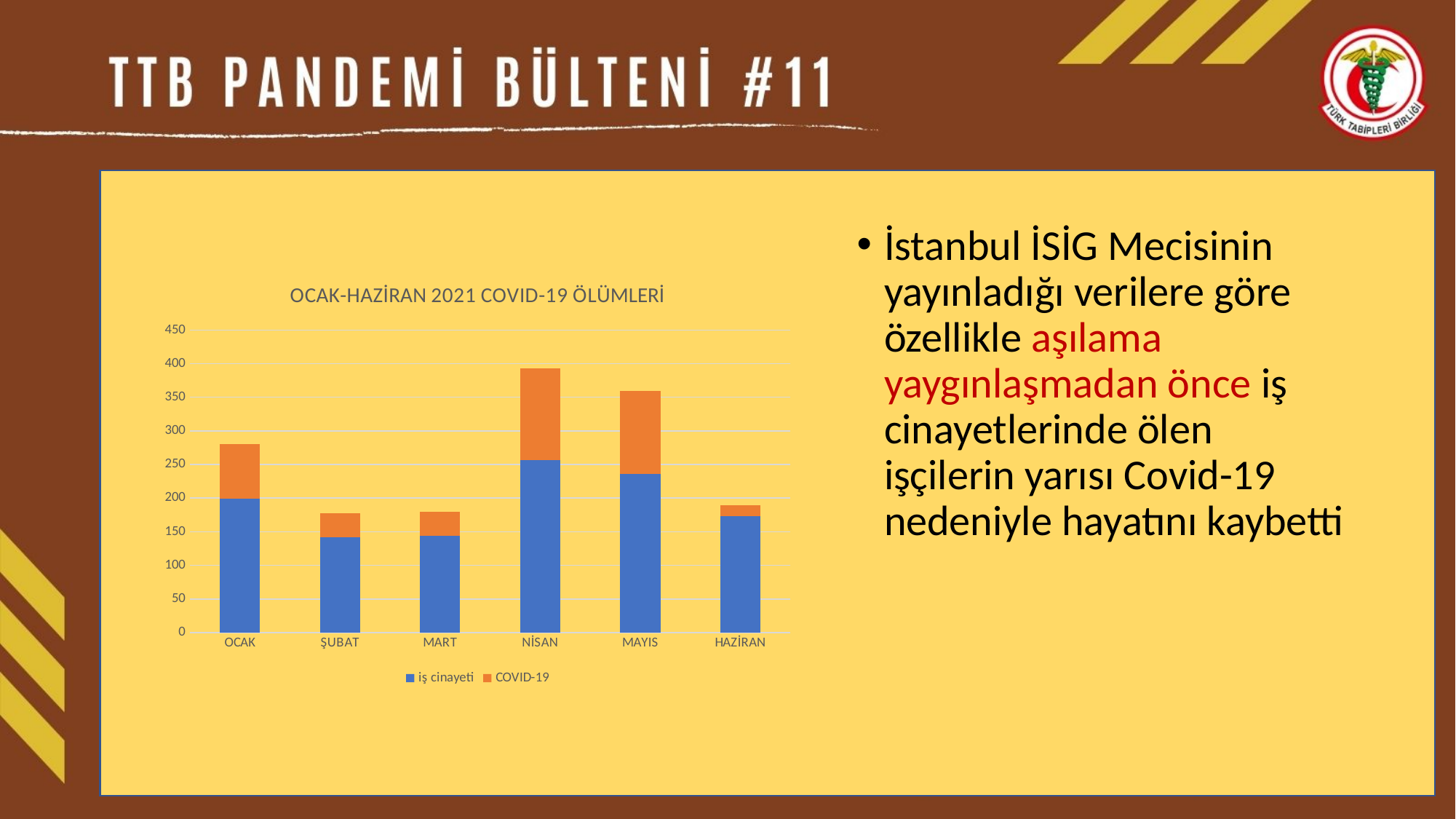
Which series is shown in orange in the chart? COVID-19 What is the title of the chart? OCAK-HAZİRAN 2021 COVID-19 ÖLÜMLERİ Is the total stacked bar for MAYIS greater or less than 300? greater Is the total stacked bar for HAZİRAN greater or less than 200? less Which month has the tallest stacked bar in the chart? NİSAN Is the total stacked bar for OCAK greater or less than 250? greater How many months (categories) are shown on the x axis of the chart? 6 Which has the taller stacked bar, NİSAN or MAYIS? NİSAN How many series does the chart's legend list? 2 Which month has the largest iş cinayeti (blue) segment? NİSAN What kind of chart is shown on the slide? Stacked bar chart Which month has the smallest COVID-19 segment in the chart? HAZİRAN